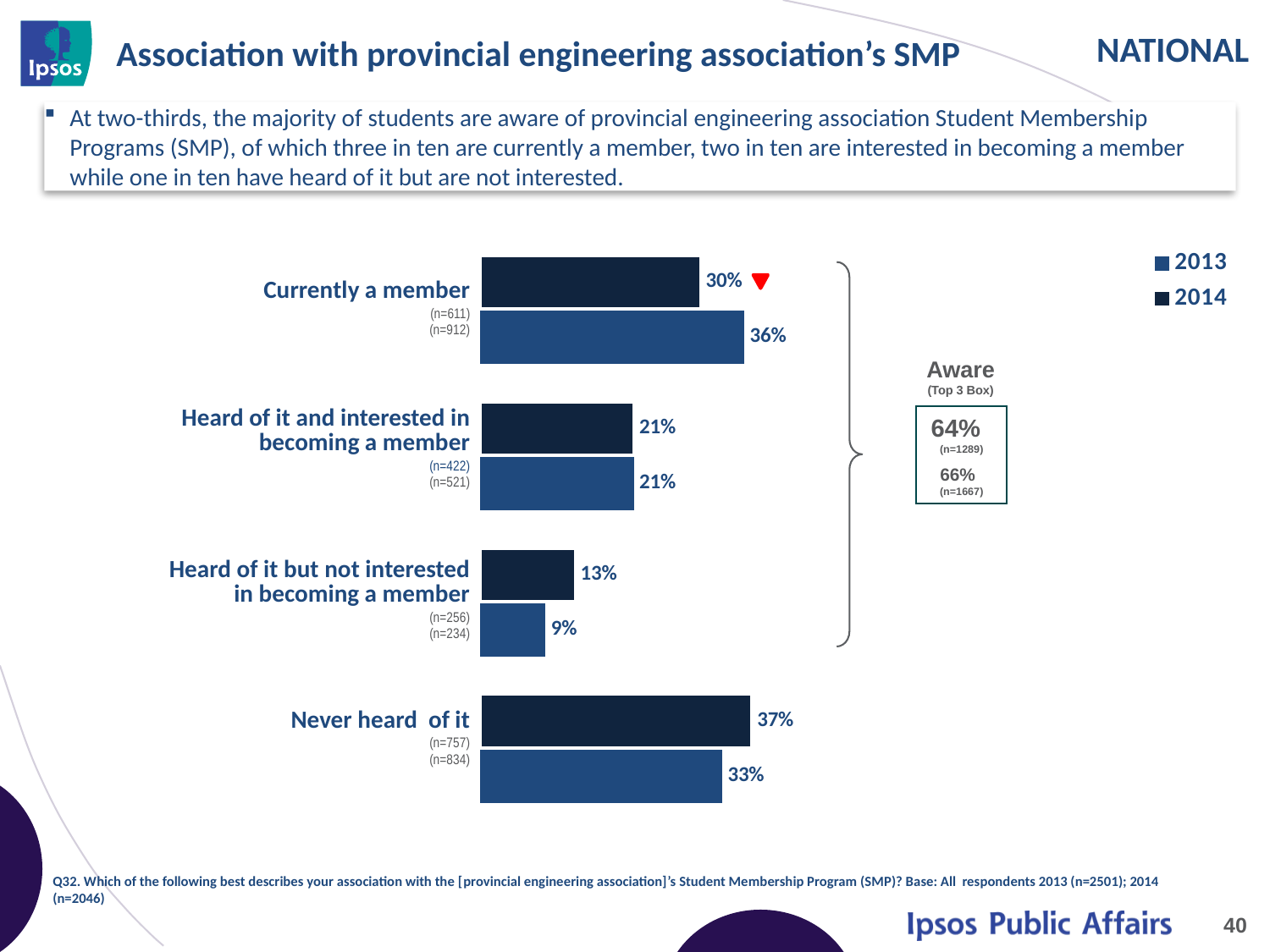
How many series does the chart legend list? 2 What years are listed in the chart legend? 2013 and 2014 What are the two values shown for 'Heard of it and interested in becoming a member'? 21% and 21% What type of chart is shown on the slide? Bar chart For 'Heard of it but not interested in becoming a member', which bar is larger, the top bar (13%) or the bottom bar (9%)? The top bar (13%) How many categories are plotted in the chart? 4 What two percentages are shown in the 'Aware (Top 3 Box)' box? 64% and 66% What is the difference between the two bars for 'Never heard of it' (37% and 33%)? 4 percentage points What is the value of the bottom (lighter blue) bar for 'Never heard of it'? 33% Which category has the lowest value shown in the chart? Heard of it but not interested in becoming a member (9%) What is the value of the top (dark navy) bar for 'Currently a member'? 30% What is the difference between the two bars for 'Currently a member' (36% and 30%)? 6 percentage points